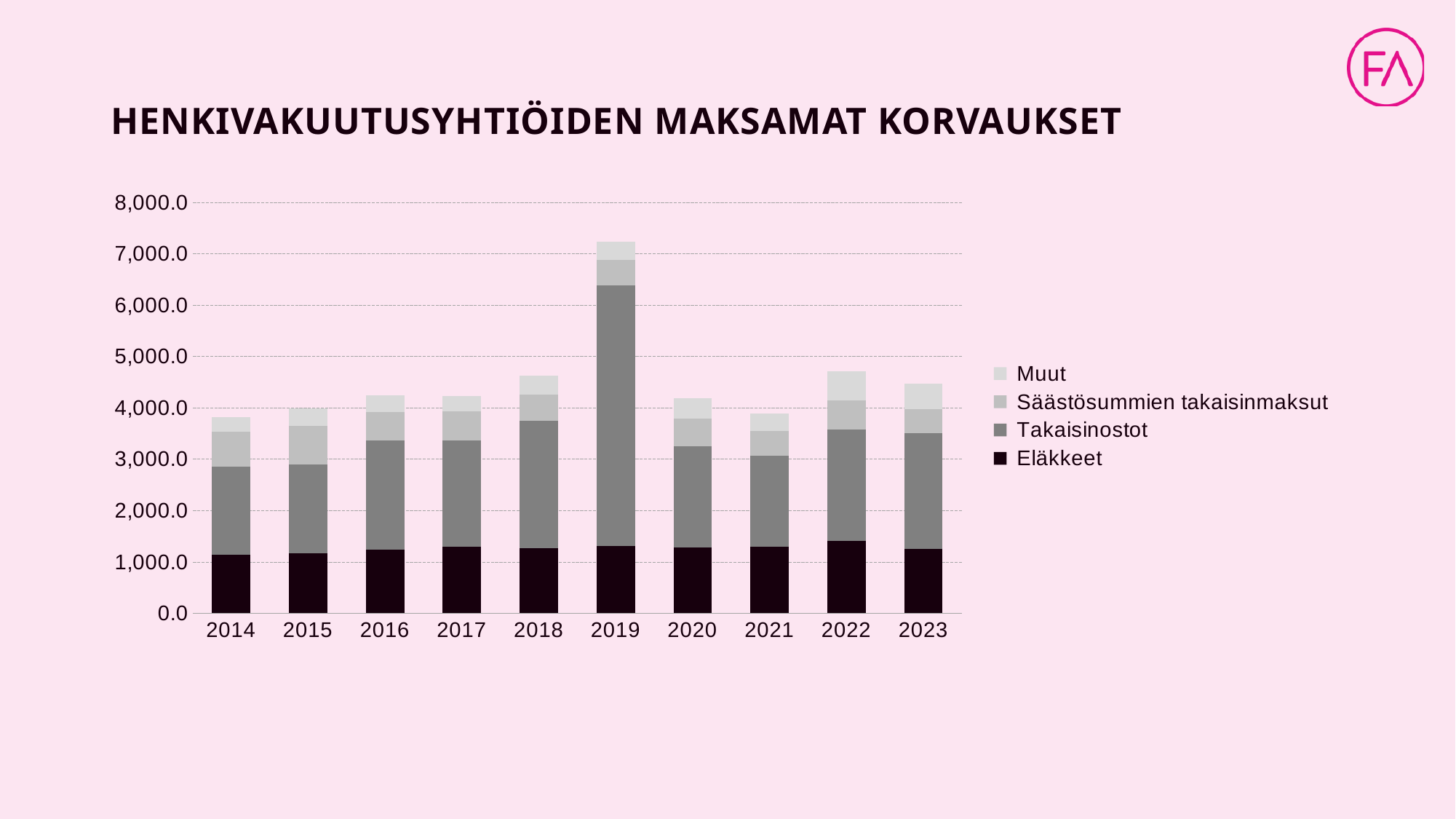
Is the total value for 2014 greater or less than 4,000.0? less Which series is shown in the darkest colour at the bottom of each bar? Eläkkeet How many series does the legend list? 4 What is the title of the chart? HENKIVAKUUTUSYHTIÖIDEN MAKSAMAT KORVAUKSET Which year has the highest total bar? 2019 Is the total value for 2019 greater or less than 7,000.0? greater Is the Eläkkeet value for 2022 greater or less than 1,000.0? greater What kind of chart is shown on the slide? Stacked bar chart How many years are shown on the x axis of the chart? 10 Which year has the larger total bar, 2018 or 2019? 2019 Which year has the larger total bar, 2021 or 2022? 2022